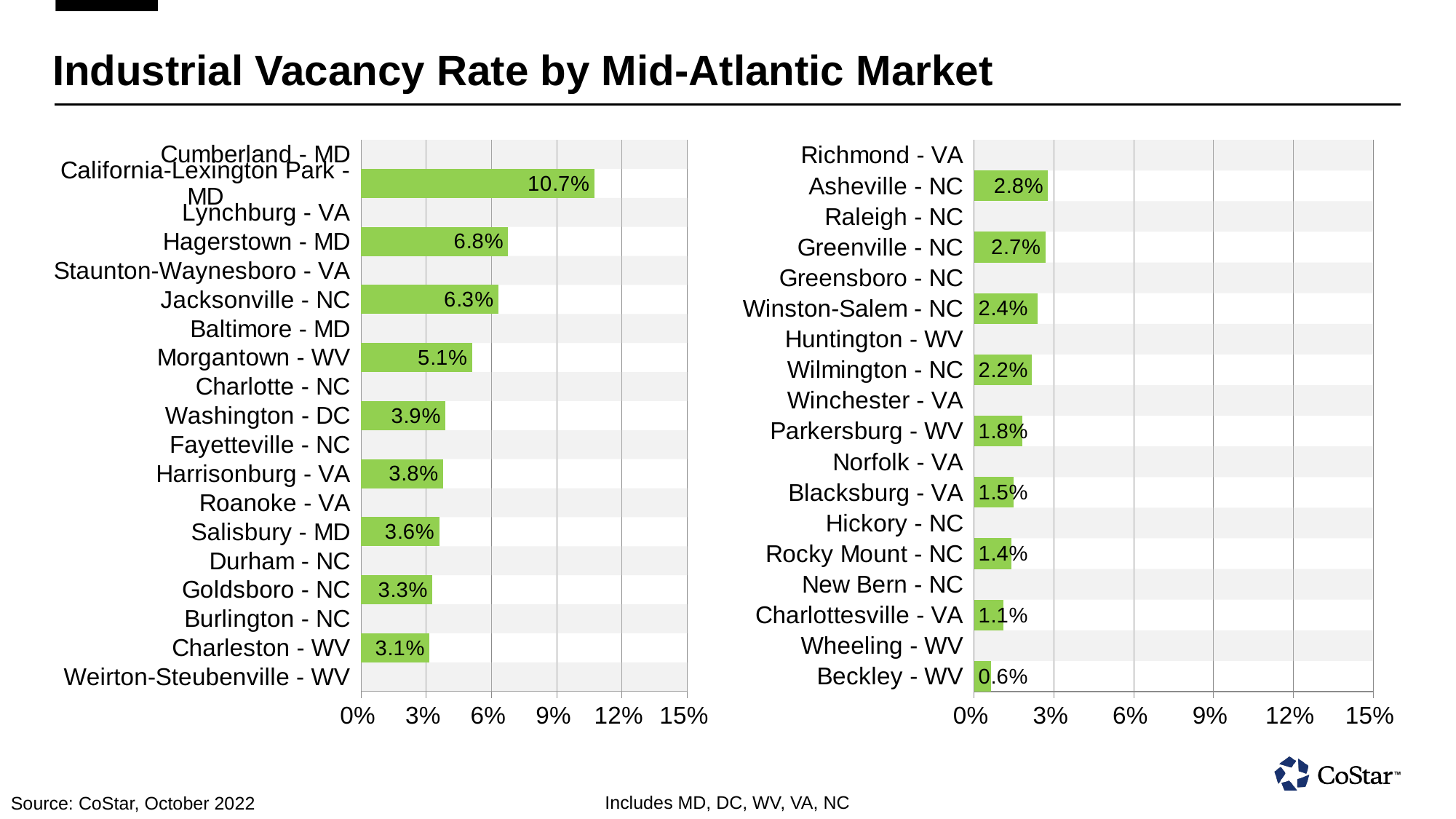
In the right chart, what is the industrial vacancy rate for Beckley - WV? 0.6% In the left chart, which market has the highest labeled vacancy rate? California-Lexington Park - MD In the right chart, which market has the lowest labeled vacancy rate? Beckley - WV What is the title of the slide? Industrial Vacancy Rate by Mid-Atlantic Market What type of chart is used on this slide? Bar chart In the right chart, what is the difference between the vacancy rates of Asheville - NC and Parkersburg - WV? 1.0% In the left chart, is the vacancy rate for California-Lexington Park - MD greater or less than 9%? greater In the left chart, what is the industrial vacancy rate for Morgantown - WV? 5.1% In the right chart, what is the industrial vacancy rate for Winston-Salem - NC? 2.4% In the left chart, what is the difference between the vacancy rates of Hagerstown - MD and Jacksonville - NC? 0.5% In the left chart, what is the industrial vacancy rate for Hagerstown - MD? 6.8% In the left chart, which has a higher vacancy rate, Washington - DC or Salisbury - MD? Washington - DC